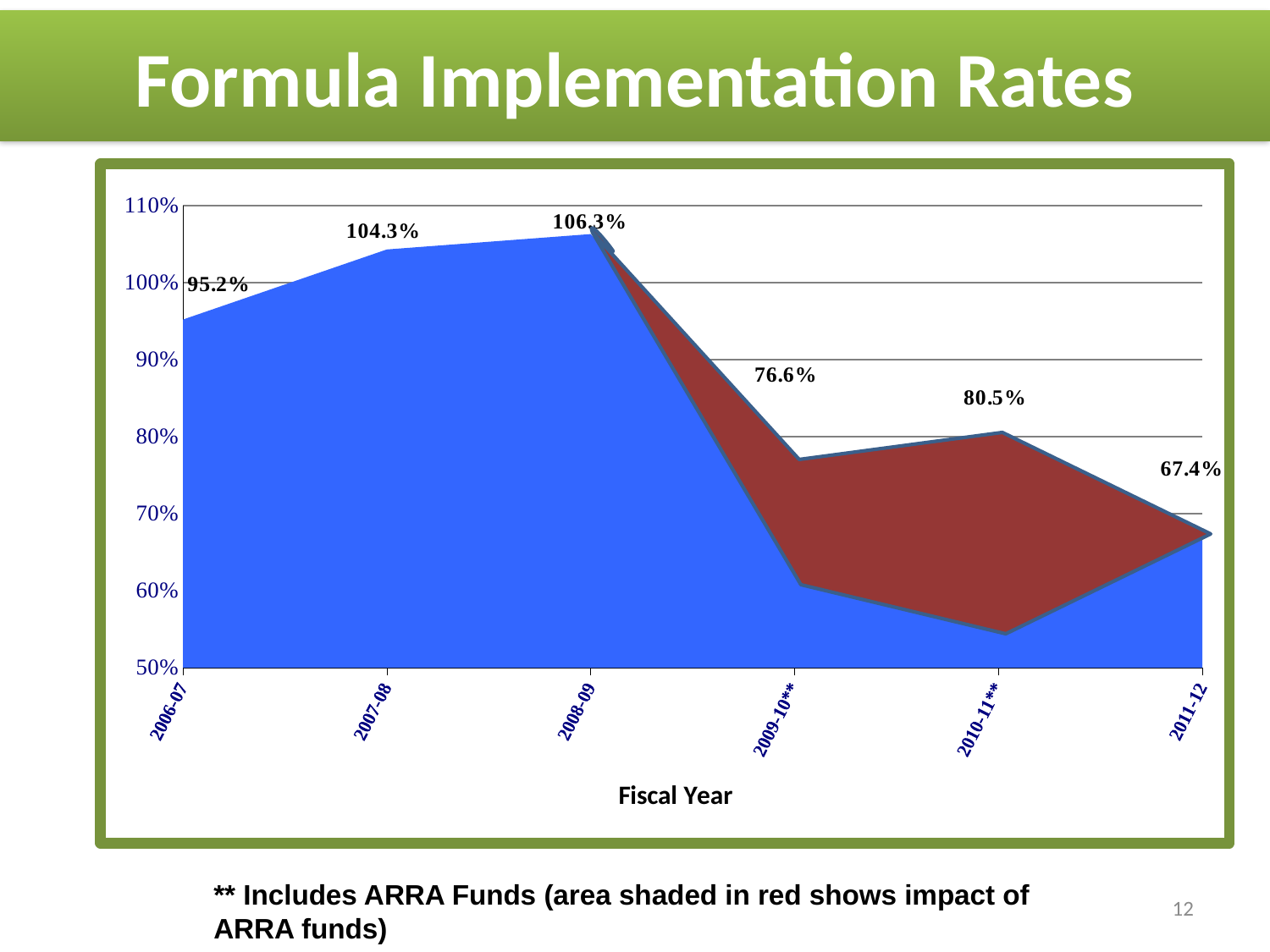
Is the top of the blue area for 2010-11** greater or less than 60%? less Does the formula implementation rate rise or fall from 2006-07 to 2008-09? rise What is the difference between the rates for 2008-09 and 2011-12? 38.9 percentage points Which fiscal year has the lowest formula implementation rate? 2011-12 Which fiscal year has the highest formula implementation rate? 2008-09 What is the formula implementation rate for 2011-12? 67.4% How many fiscal years are shown on the x axis? 6 What kind of chart is shown on the slide? area chart What is the formula implementation rate labelled for 2010-11**? 80.5% What is the formula implementation rate for 2006-07? 95.2% Which is larger, the rate for 2009-10** or the rate for 2010-11**? 2010-11** What is the formula implementation rate for 2008-09? 106.3%